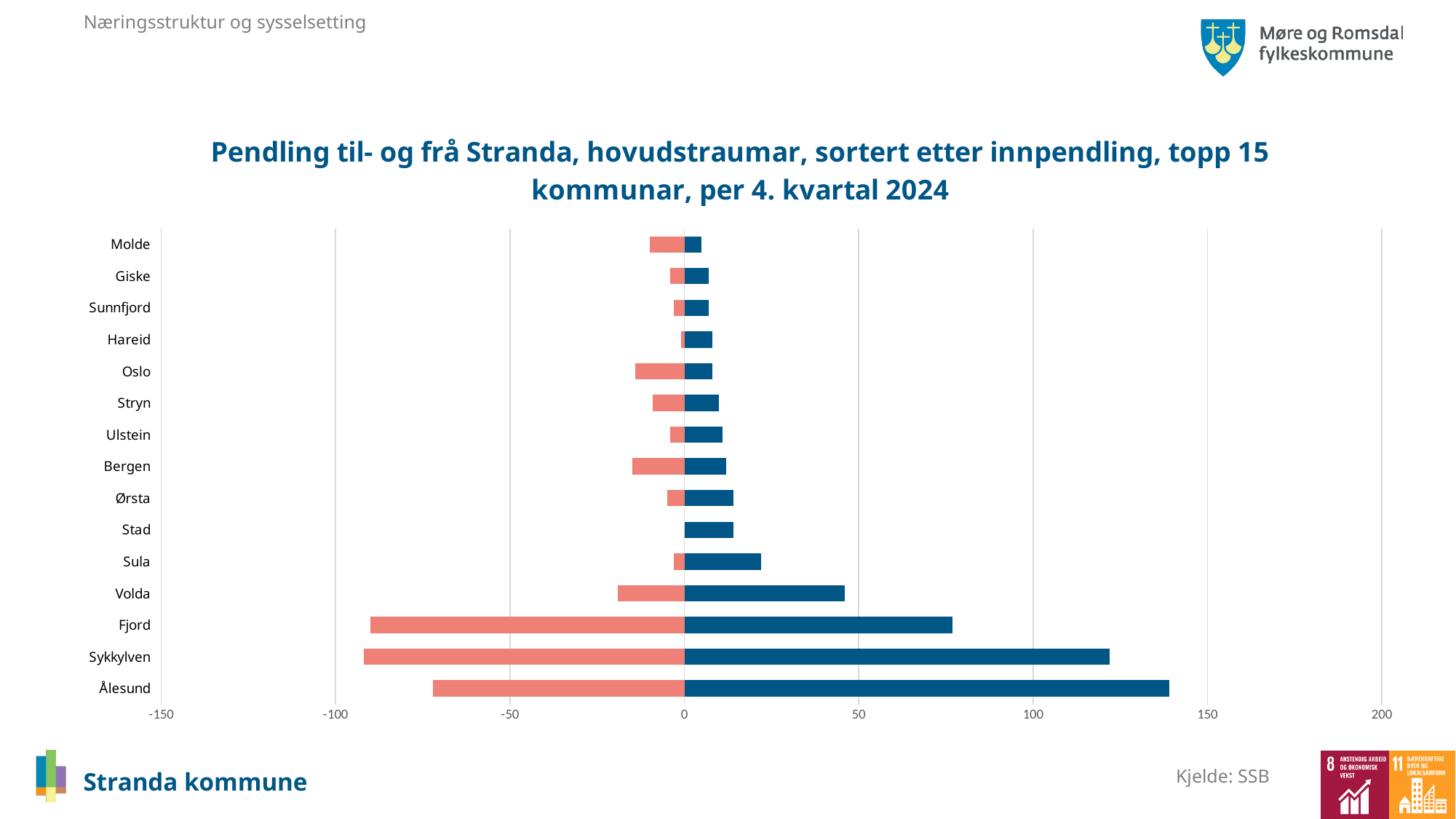
Is the red bar value for Sykkylven greater or less than -50? less How many municipalities (categories) are listed on the vertical axis of the chart? 15 Which municipality has the shortest blue bar (lowest positive value)? Molde Which has the longer red bar, Fjord or Ålesund? Fjord Is the blue bar value for Volda greater or less than 50? less What kind of chart is shown on the slide? bar chart Is the blue bar value for Ålesund greater or less than 100? greater What source is cited for the chart data on the slide? SSB Which municipality has the longest blue bar (highest positive value)? Ålesund Which has the longer blue bar, Fjord or Volda? Fjord